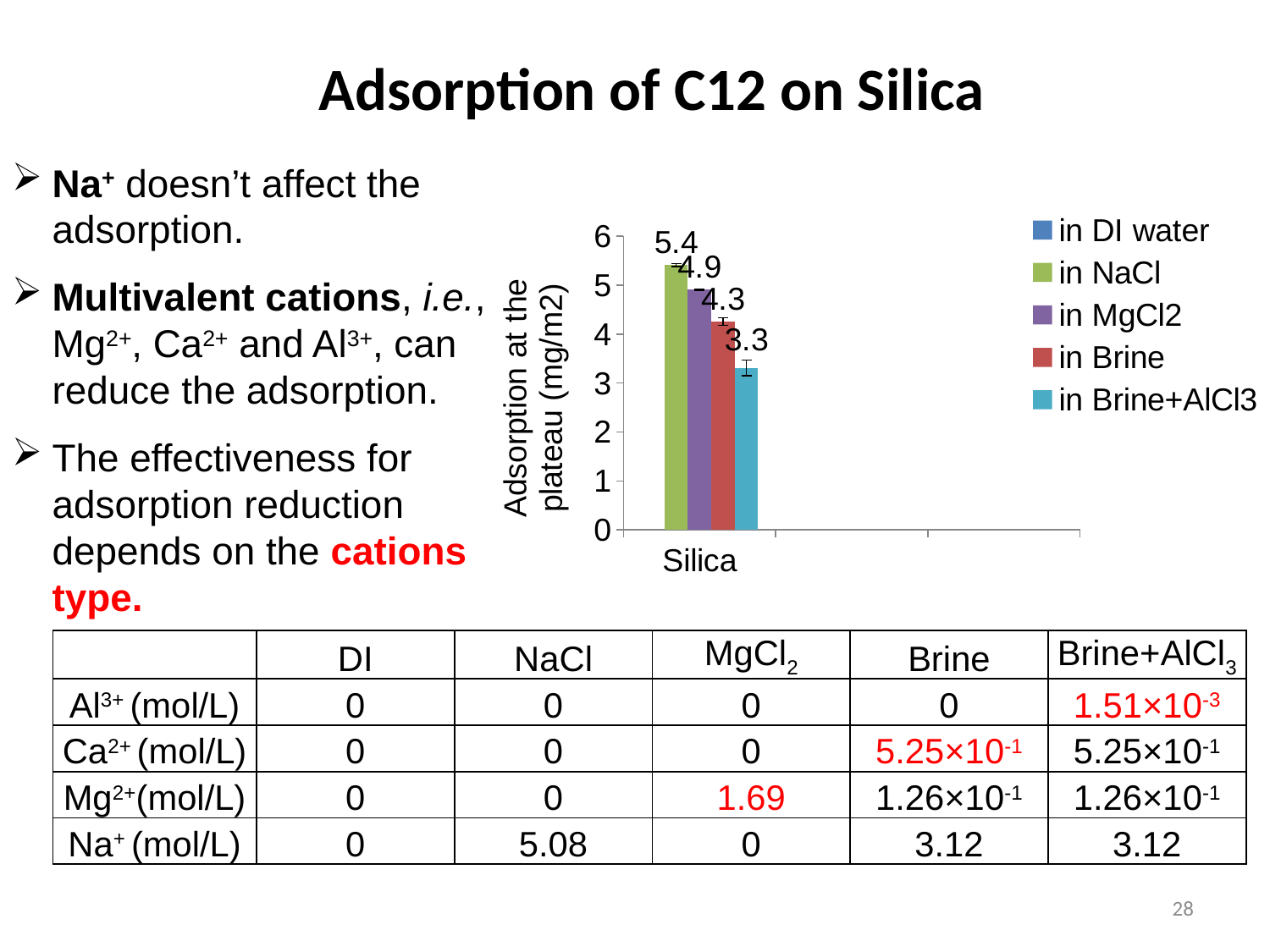
Which is larger, the value for 'in Brine' or the value for 'in Brine+AlCl3'? in Brine How many series does the chart legend list? 5 Which of the bars shown has the lowest adsorption value? in Brine+AlCl3 What is the adsorption value for the 'in NaCl' series? 5.4 What kind of chart is shown on the slide? bar chart Is the value for 'in Brine+AlCl3' greater or less than 4? less What is the adsorption value for the 'in Brine' series? 4.3 What is the difference between the 'in NaCl' value and the 'in Brine+AlCl3' value? 2.1 What is the difference between the 'in MgCl2' value and the 'in Brine' value? 0.6 What is the adsorption value for the 'in Brine+AlCl3' series? 3.3 What is the adsorption value for the 'in MgCl2' series? 4.9 What is the label on the vertical axis of the chart? Adsorption at the plateau (mg/m2)